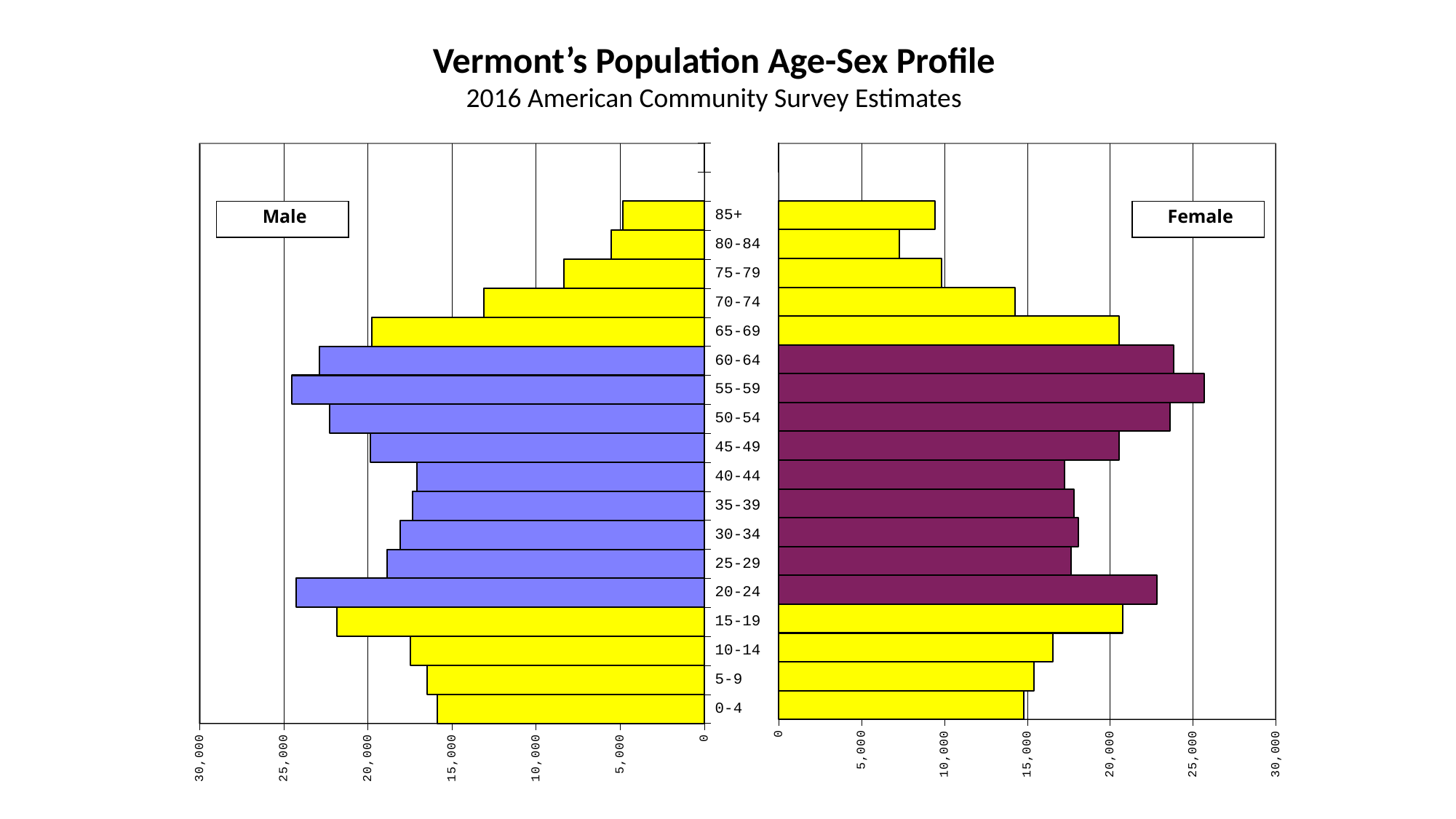
On the Male chart, which age group has the larger population: 20-24 or 25-29? 20-24 On the Female chart, is the value for the 20-24 age group greater or less than 20,000? greater How many age groups are shown on the Male chart? 18 On the Female chart, is the value for the 70-74 age group greater or less than 15,000? less On the Male chart, is the value for the 60-64 age group greater or less than 20,000? greater What is the main title of the slide? Vermont's Population Age-Sex Profile What kind of chart is used on this slide for the Male and Female population profiles? bar chart On the Female chart, which age group has the lowest population? 80-84 On the Female chart, which age group has the highest population? 55-59 On the Male chart, which age group has the lowest population? 85+ On the Female chart, which age group has the larger population: 60-64 or 40-44? 60-64